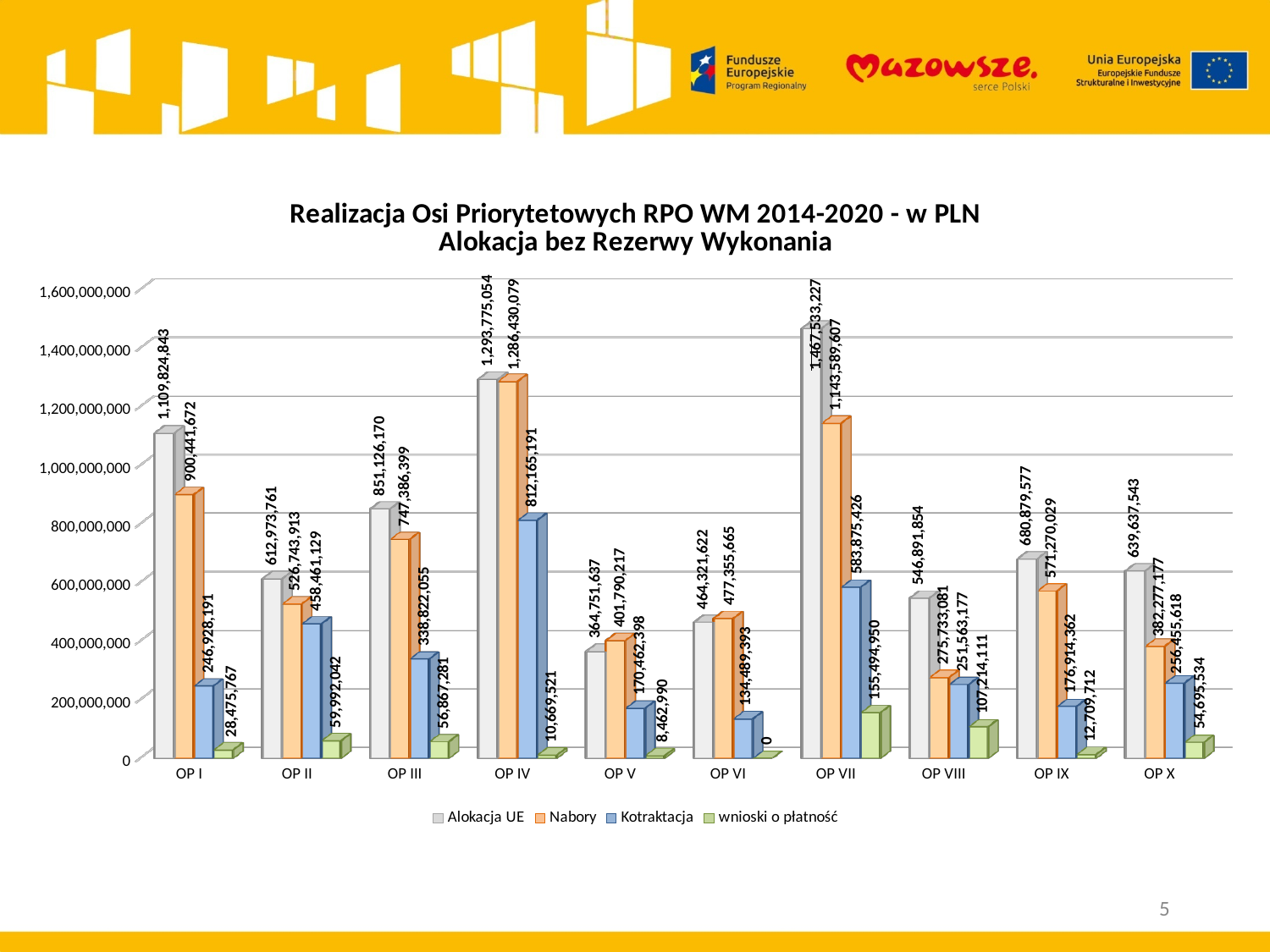
What is the wnioski o płatność value for OP VII? 155,494,950 What is the difference between Alokacja UE and Nabory for OP I? 209,383,171 Which category has the highest Alokacja UE value? OP VII How many priority axes (OP categories) are shown on the x axis? 10 What is the Alokacja UE value for OP VII? 1,467,533,227 What kind of chart is shown on the slide? bar chart Which category has the highest Kotraktacja value? OP IV What is the Kotraktacja value for OP II? 458,461,129 What is the Nabory value for OP IV? 1,286,430,079 Which category has the lowest wnioski o płatność value? OP VI How many series does the legend list? 4 For OP V, which is larger: Alokacja UE or Nabory? Nabory